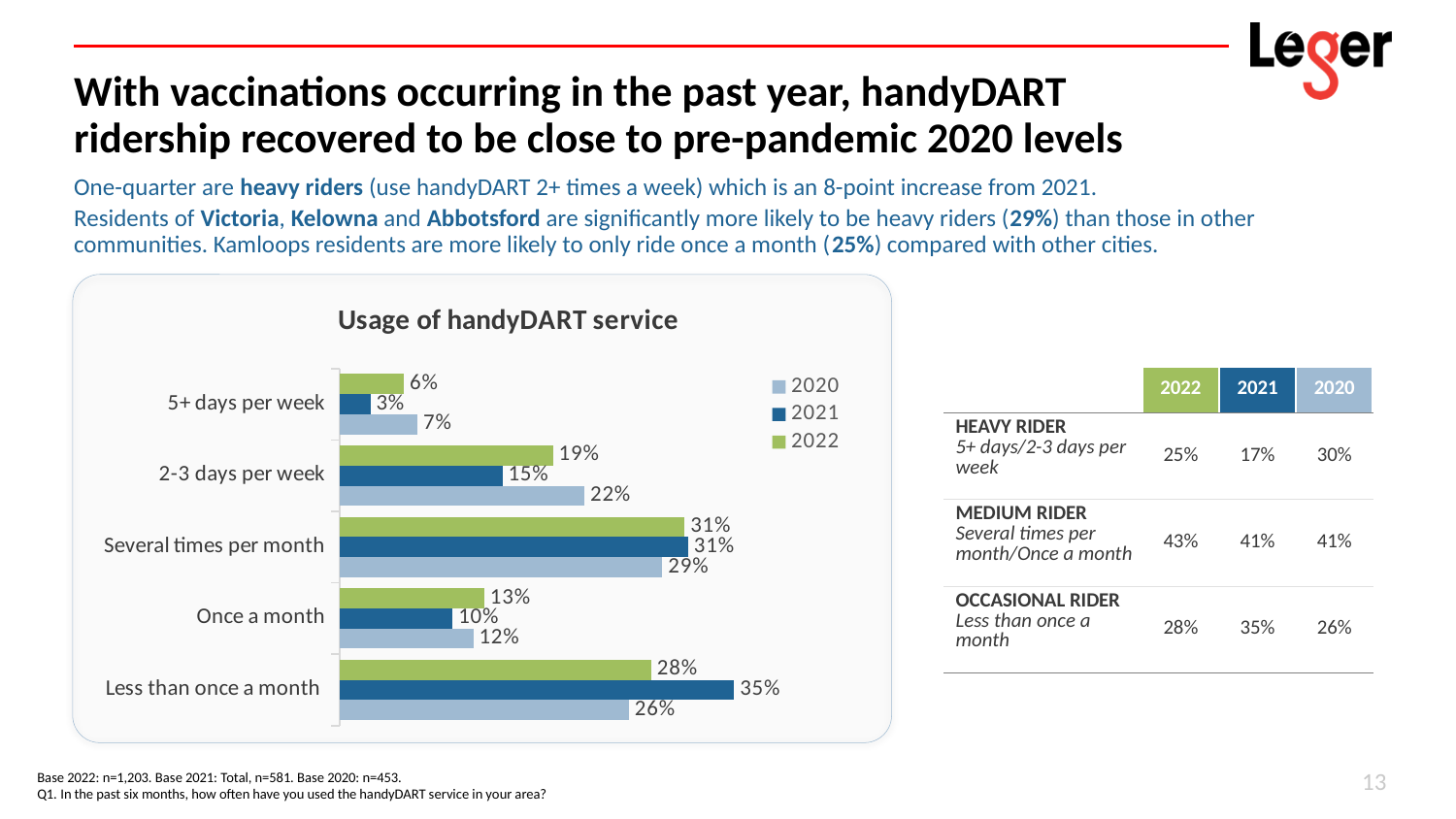
In the 'Usage of handyDART service' chart, what is the 2022 value for 'Less than once a month'? 28% In the 'Usage of handyDART service' chart, which is larger for 'Once a month': the 2022 value or the 2020 value? 2022 In the 'Usage of handyDART service' chart, what is the difference between the 2020 and 2021 values for '2-3 days per week'? 7% In the 'Usage of handyDART service' chart, which category has the highest 2021 value? Less than once a month In the 'Usage of handyDART service' chart, which category has the lowest 2022 value? 5+ days per week In the 'Usage of handyDART service' chart, what is the 2021 value for '5+ days per week'? 3% In the 'Usage of handyDART service' chart, what is the difference between the 2021 and 2022 values for 'Less than once a month'? 7% How many series does the legend of the 'Usage of handyDART service' chart list? 3 How many categories are shown in the 'Usage of handyDART service' chart? 5 In the 'Usage of handyDART service' chart, which series is shown in green? 2022 In the 'Usage of handyDART service' chart, what is the 2020 value for '2-3 days per week'? 22% What kind of chart is 'Usage of handyDART service'? Bar chart